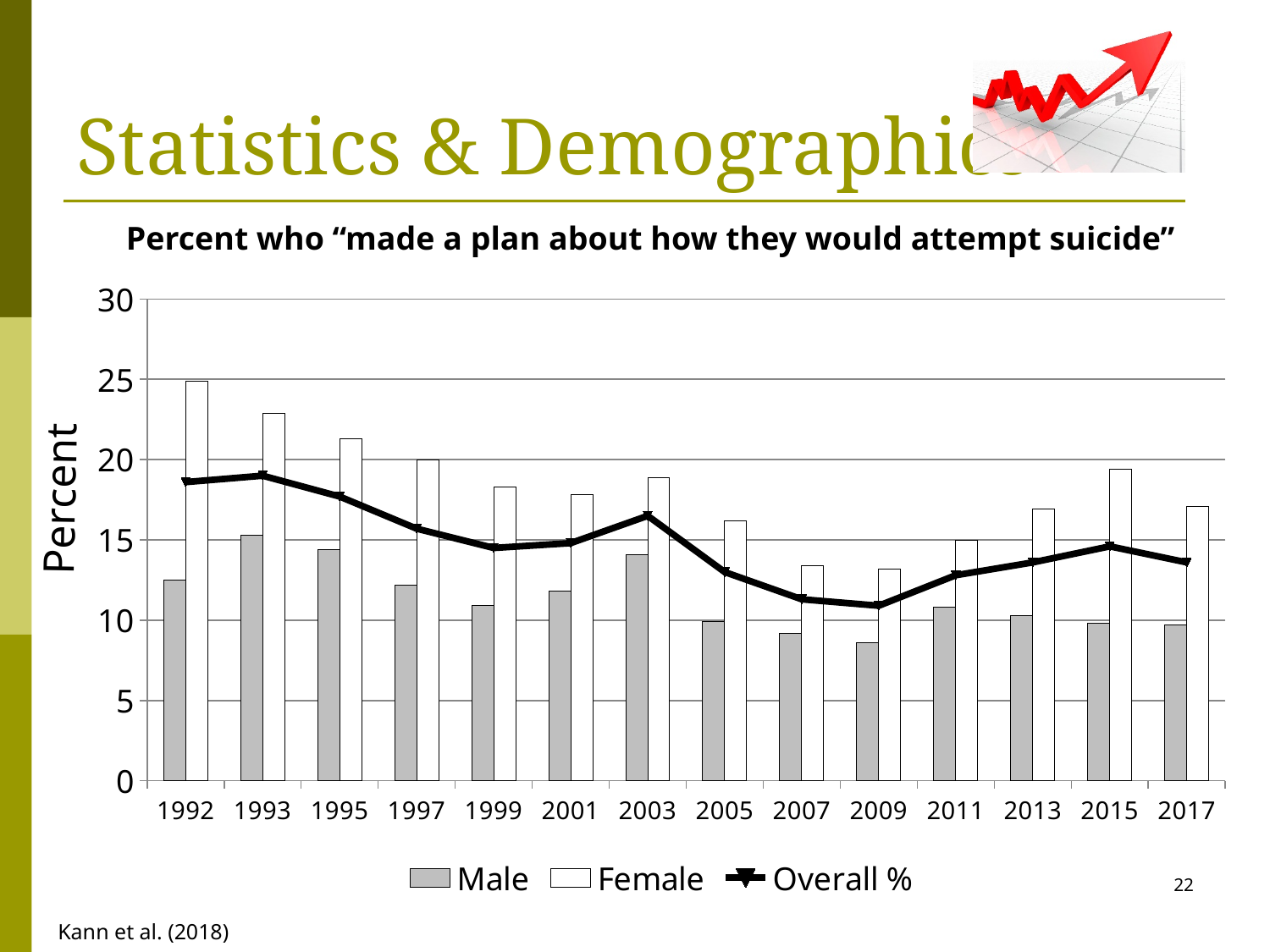
Is the Male value for 2009 greater or less than 10? less What is the label on the y axis of the chart? Percent Which is larger, the Male value for 1993 or the Male value for 2009? 1993 Which is larger, the Female value for 1992 or the Female value for 2017? 1992 Does the Overall % line rise or fall from 1993 to 2009? fall How many series does the chart legend list? 3 Is the Overall % value for 1993 greater or less than 15? greater Is the Female value for 1992 greater or less than 20? greater In which year is the Female bar highest? 1992 How many years are shown on the x axis of the chart? 14 What kind of chart is shown on the slide? bar chart with a line